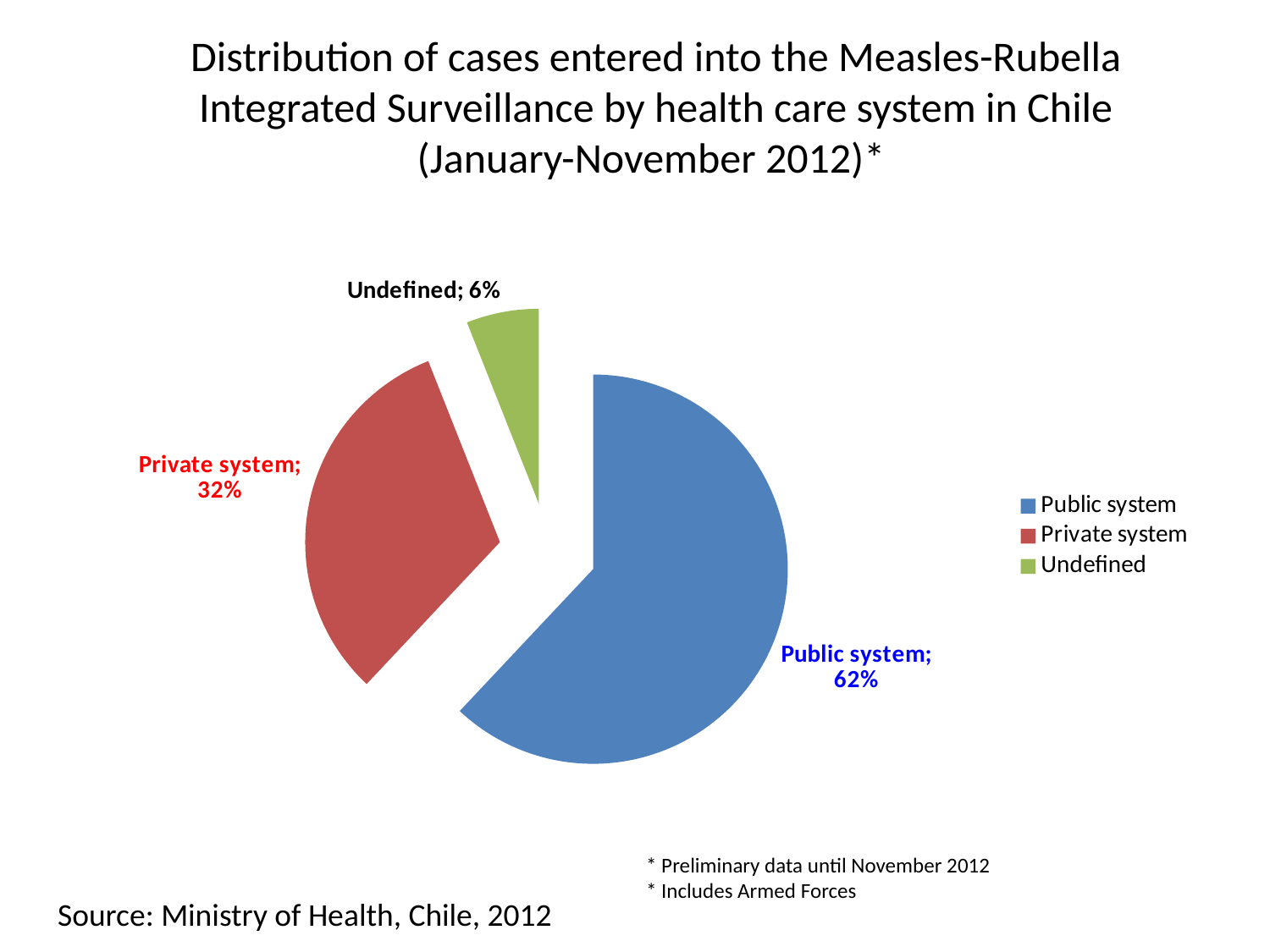
What kind of chart is shown on the slide? Pie chart What colour is the slice for the Private system? Red What is the source cited for the chart data? Ministry of Health, Chile, 2012 Which health care system category has the largest share of cases? Public system How many categories are shown in the pie chart? 3 What share of cases is labelled Undefined? 6% What is the difference in percentage points between the Public system and Private system shares? 30 How many entries does the legend list? 3 What share of cases is attributed to the Public system? 62% Which category has the smallest share of cases? Undefined Which is larger, the share for the Private system or the share for Undefined? Private system What share of cases is attributed to the Private system? 32%